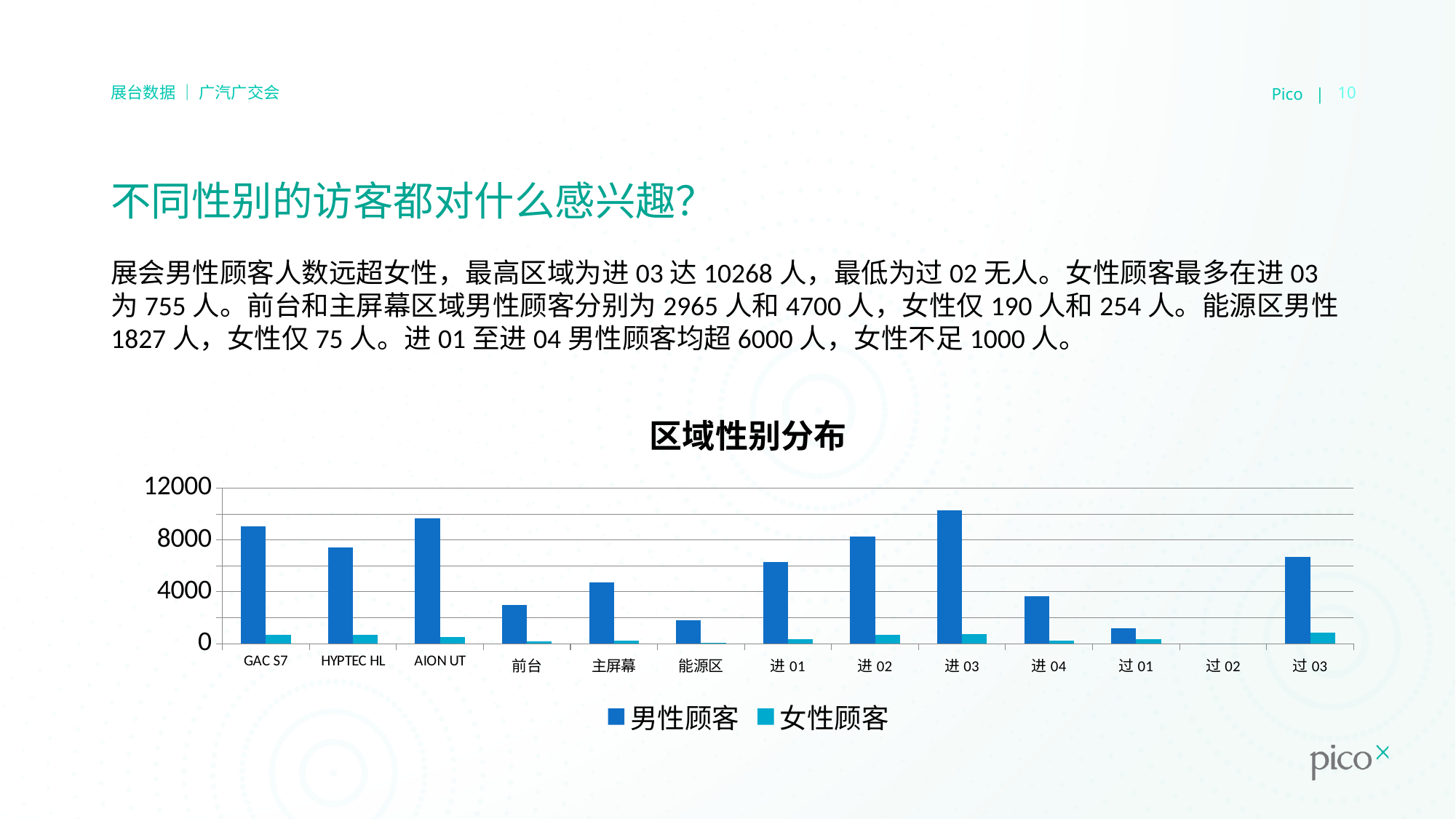
What is the difference between the 男性顾客 values for 主屏幕 and 前台? 1735 What kind of chart is shown on the slide? bar chart Is the 男性顾客 value for GAC S7 greater or less than 8000? greater Is the 男性顾客 value for 进 04 greater or less than 4000? less Which category has the lowest value for 男性顾客? 过 02 Which is larger, the 男性顾客 value for 进 02 or for 进 01? 进 02 Which category has the highest value for 男性顾客? 进 03 How many series does the legend of the 区域性别分布 chart list? 2 How many categories are shown on the x axis of the 区域性别分布 chart? 13 What is the 女性顾客 value for 进 03? 755 What is the 男性顾客 value for 主屏幕? 4700 What is the 男性顾客 value for 进 03? 10268